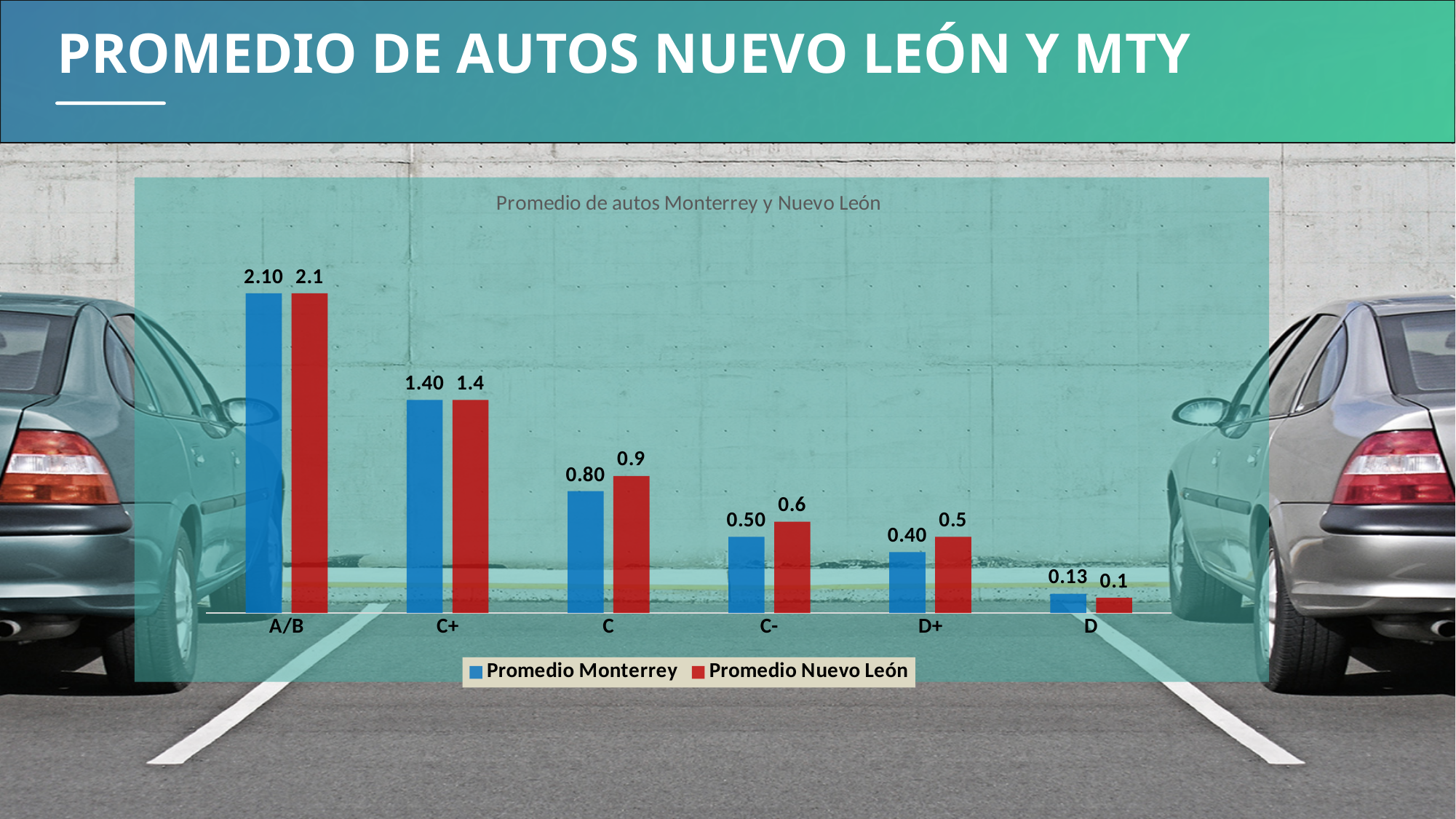
How many series does the legend list? 2 What is the value for Promedio Nuevo León in category C-? 0.6 What is the value for Promedio Monterrey in category C? 0.80 What is the value for Promedio Monterrey in category D? 0.13 What is the difference between Promedio Nuevo León and Promedio Monterrey in category C? 0.1 What kind of chart is shown on the slide? Bar chart How many categories are shown on the x axis? 6 Which category has the lowest value for Promedio Monterrey? D What is the title of the chart? Promedio de autos Monterrey y Nuevo León Do the values for Promedio Monterrey rise or fall from A/B to D? Fall Which category has the highest value for Promedio Nuevo León? A/B In category D, which series has the larger value, Promedio Monterrey or Promedio Nuevo León? Promedio Monterrey